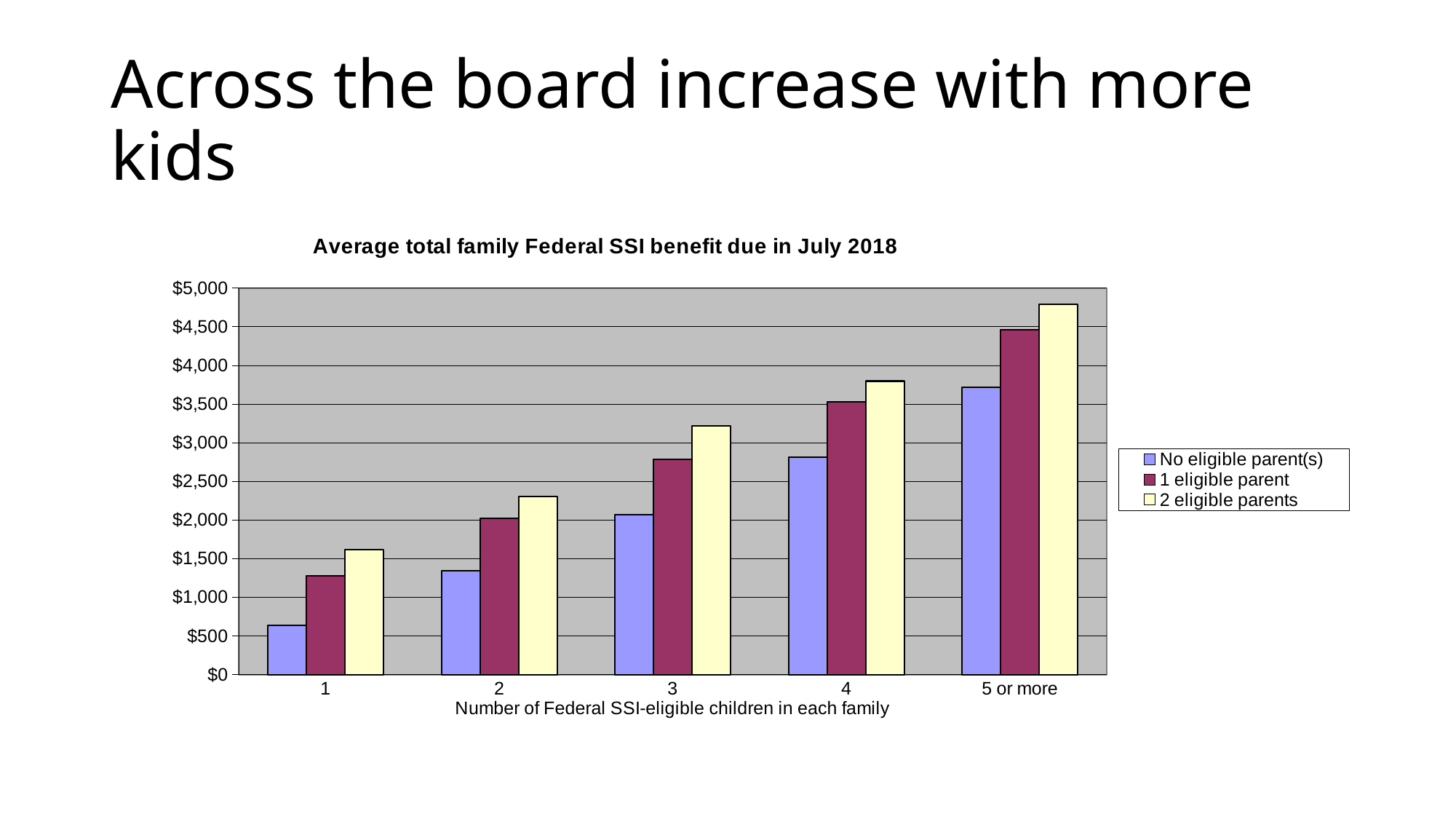
Is the value for 2 eligible parents with 2 children greater or less than $2,000? greater Which category has the lowest value for the No eligible parent(s) series? 1 Do the values for the 1 eligible parent series rise or fall as the number of children increases? rise How many categories are shown on the x axis? 5 Is the value for 2 eligible parents with 5 or more children greater or less than $4,500? greater What type of chart is shown on the slide? bar chart What is the x-axis label of the chart? Number of Federal SSI-eligible children in each family Is the value for No eligible parent(s) with 1 child greater or less than $1,000? less How many series does the legend list? 3 What is the title of the chart? Average total family Federal SSI benefit due in July 2018 Which category has the highest value for the 2 eligible parents series? 5 or more